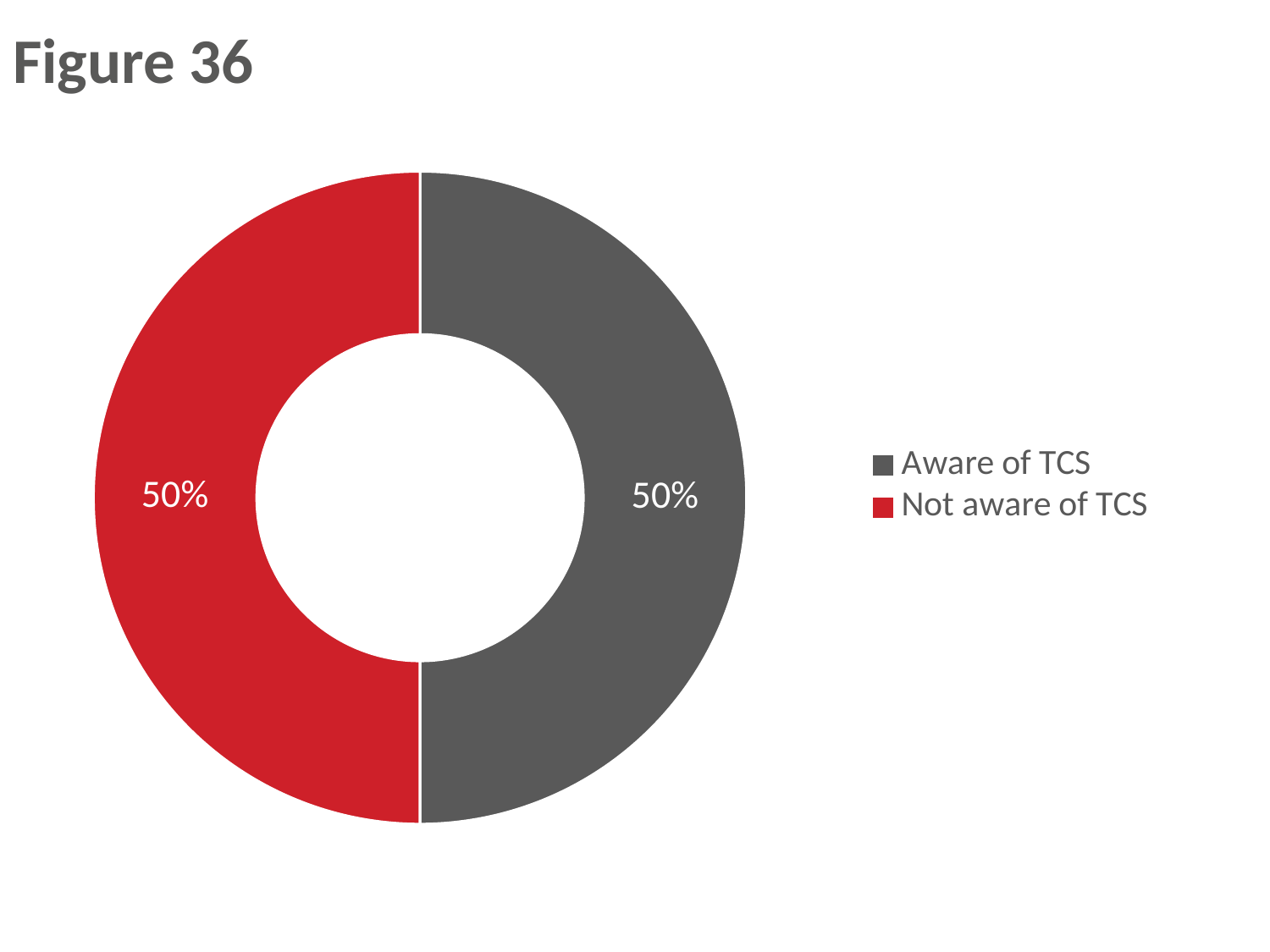
What percentage of respondents are aware of TCS? 50% What share of the chart does the 'Not aware of TCS' slice represent? 50% Which colour represents 'Aware of TCS' in the chart? Grey What is the difference between the share aware of TCS and the share not aware of TCS? 0% How many entries does the legend list? 2 What is the title of the slide? Figure 36 What is the combined share of the two slices? 100% How many categories does the chart show? 2 What percentage of respondents are not aware of TCS? 50% What kind of chart is shown on the slide? Doughnut chart